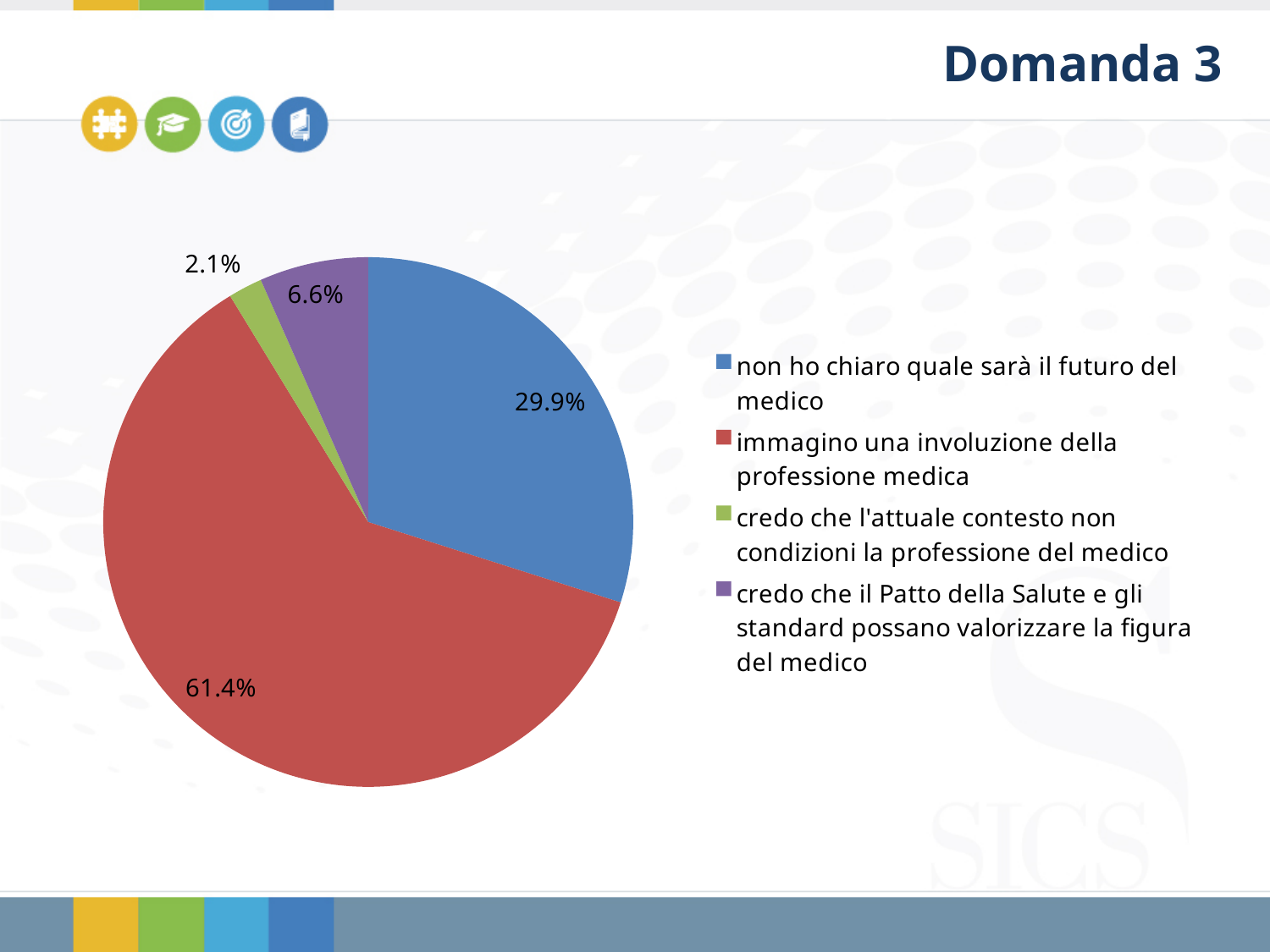
How many slices does the pie chart have? 4 What share of the pie is labelled "non ho chiaro quale sarà il futuro del medico"? 29.9% What share of the pie is labelled "credo che il Patto della Salute e gli standard possano valorizzare la figura del medico"? 6.6% What share of the pie is labelled "immagino una involuzione della professione medica"? 61.4% Which is larger: the slice for "credo che il Patto della Salute e gli standard possano valorizzare la figura del medico" or the slice for "credo che l'attuale contesto non condizioni la professione del medico"? credo che il Patto della Salute e gli standard possano valorizzare la figura del medico Which category has the smallest slice of the pie? credo che l'attuale contesto non condizioni la professione del medico What kind of chart is shown on the slide? pie chart Which category has the largest slice of the pie? immagino una involuzione della professione medica What share of the pie is labelled "credo che l'attuale contesto non condizioni la professione del medico"? 2.1% What colour is the slice for "immagino una involuzione della professione medica"? red What is the difference in percentage points between the "immagino una involuzione della professione medica" slice and the "non ho chiaro quale sarà il futuro del medico" slice? 31.5 What is the title of the slide containing the pie chart? Domanda 3